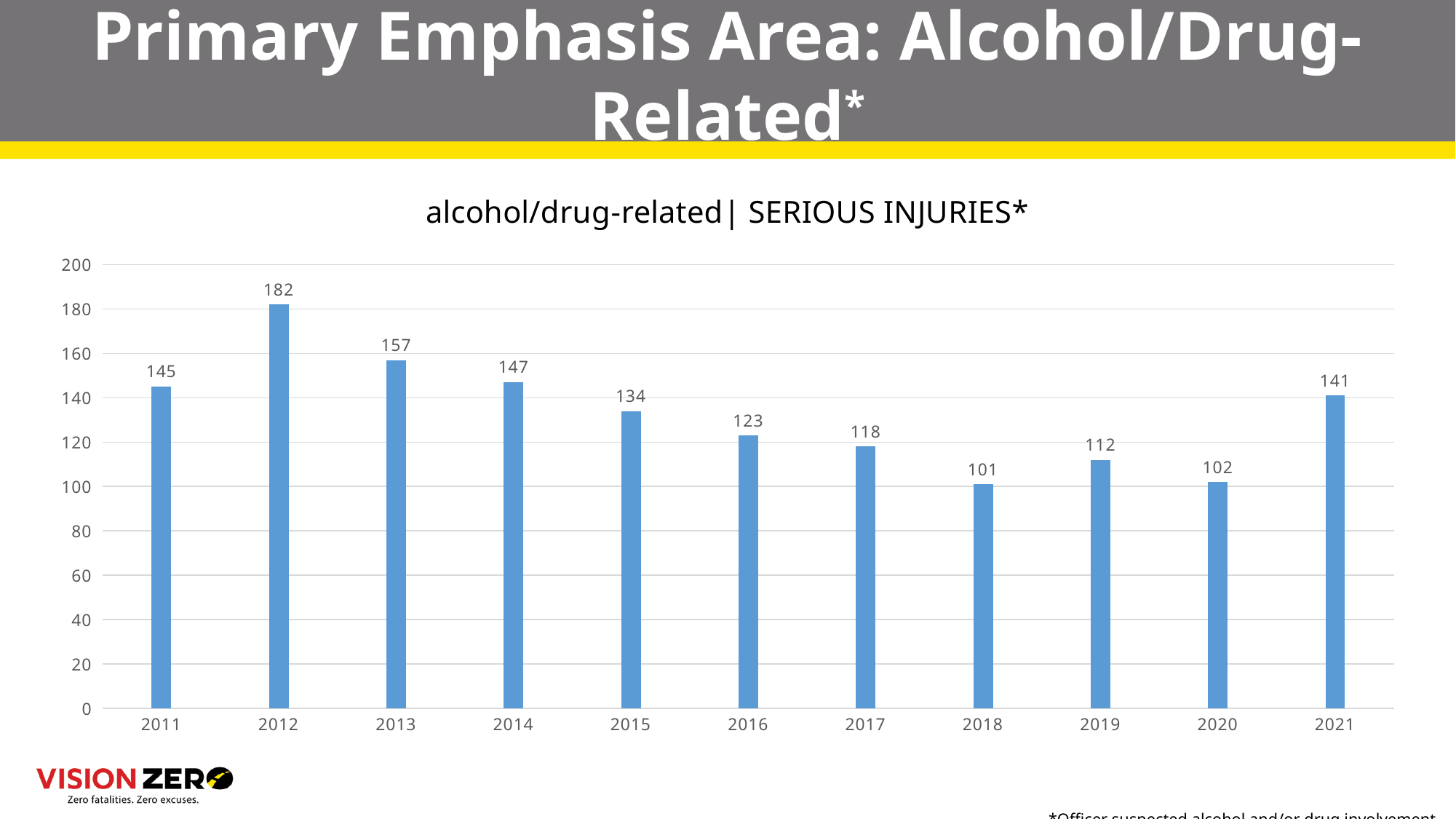
Which year has the highest value? 2012 Is the value for 2016 greater or less than 140? less What is the title of the chart? alcohol/drug-related| SERIOUS INJURIES* What is the difference between the values for 2012 and 2013? 25 How many years are shown on the x axis? 11 What is the value for 2012? 182 Which year has the lowest value? 2018 Which is larger, the value for 2011 or the value for 2014? 2014 What is the difference between the values for 2021 and 2020? 39 What is the value for 2018? 101 What kind of chart is shown? bar chart What is the value for 2021? 141